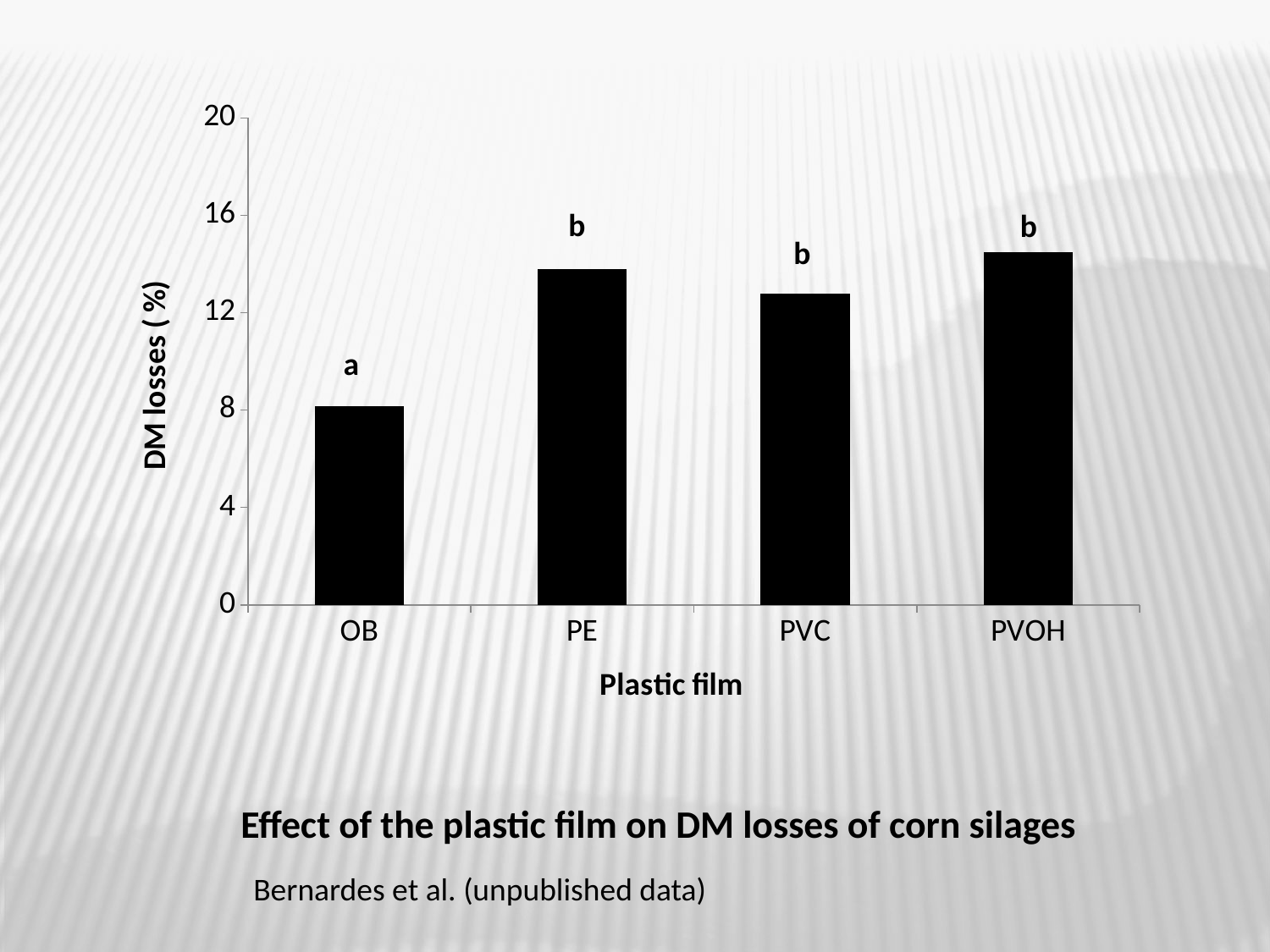
Is the value for PVC greater or less than 8? greater Is the value for PE greater or less than 12? greater What kind of chart is shown on the slide? bar chart Is the value for PVOH greater or less than 16? less Which plastic film has the lowest DM losses? OB Which has higher DM losses, OB or PVC? PVC What is the title of the y axis? DM losses ( %) Which has higher DM losses, PE or PVC? PE How many plastic film categories are plotted on the x axis? 4 What letter is printed above the OB bar? a Which plastic film has the highest DM losses? PVOH